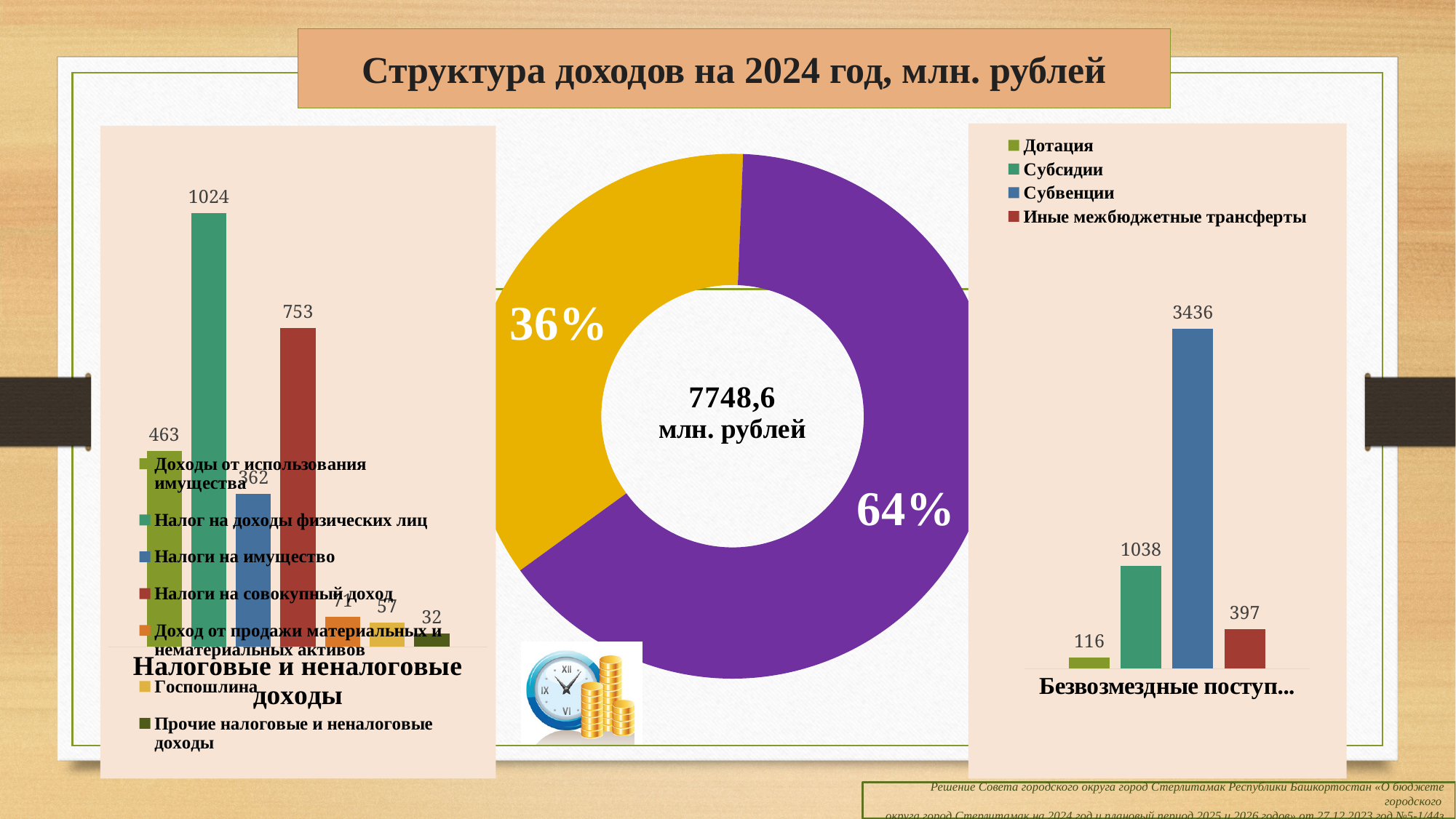
What total value is printed in the center of the donut chart? 7748,6 млн. рублей In the left bar chart 'Налоговые и неналоговые доходы', which category has the lowest value? Прочие налоговые и неналоговые доходы In the right bar chart 'Безвозмездные поступ...', which category has the highest value? Субвенции In the left bar chart 'Налоговые и неналоговые доходы', what is the difference between 'Доходы от использования имущества' and 'Налоги на имущество'? 101 In the right bar chart 'Безвозмездные поступ...', how many series does the legend list? 4 In the center donut chart, what share does the purple slice represent? 64% In the right bar chart 'Безвозмездные поступ...', what is the value for 'Субвенции'? 3436 In the left bar chart 'Налоговые и неналоговые доходы', what is the value for 'Налоги на совокупный доход'? 753 In the left bar chart 'Налоговые и неналоговые доходы', how many bars are plotted? 7 In the right bar chart 'Безвозмездные поступ...', which is larger: 'Субсидии' or 'Иные межбюджетные трансферты'? Субсидии In the left bar chart 'Налоговые и неналоговые доходы', what is the value for 'Налог на доходы физических лиц'? 1024 In the right bar chart 'Безвозмездные поступ...', what is the value for 'Дотация'? 116